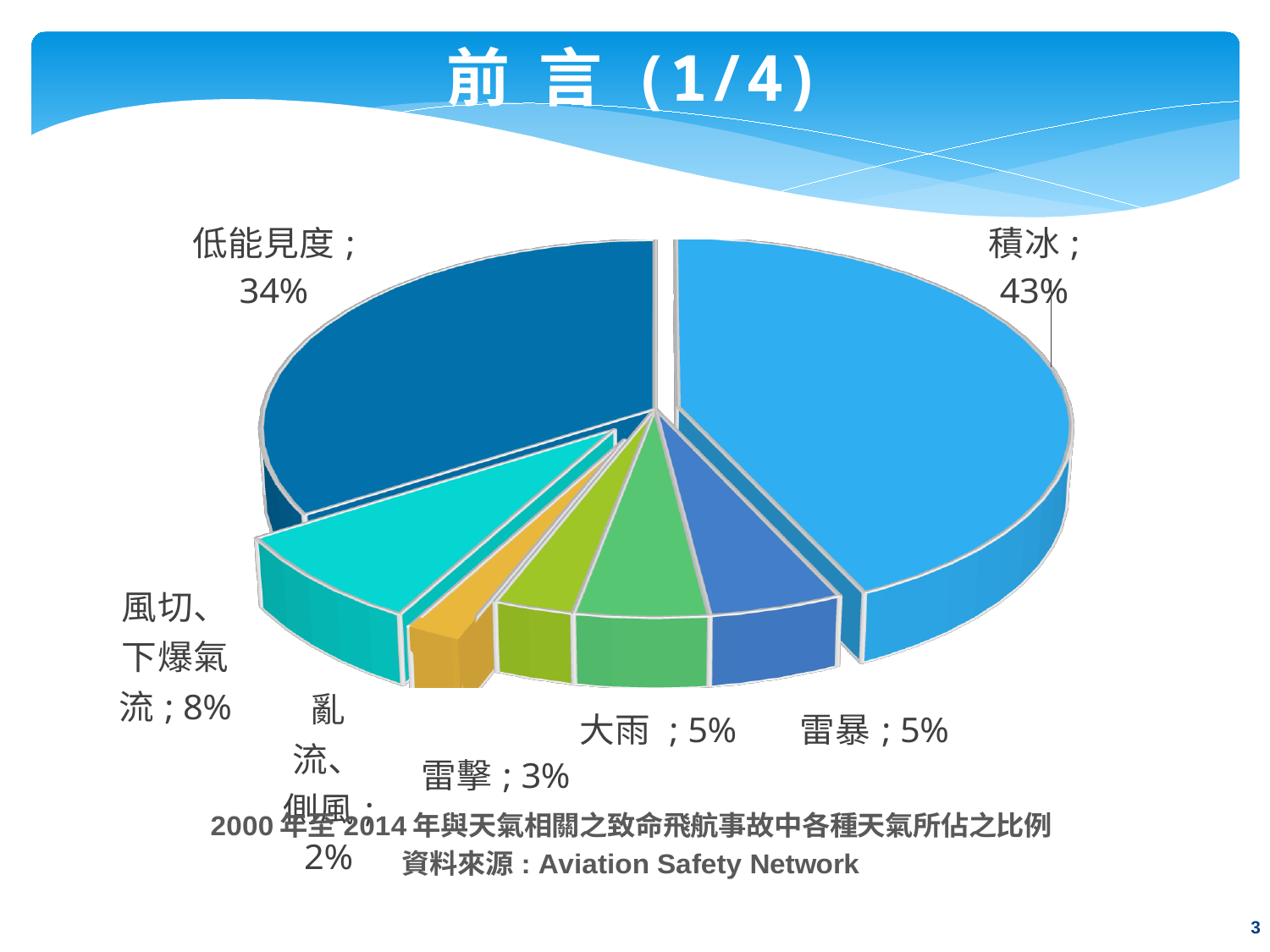
What is the value shown for 風切、下爆氣流? 8% What share of the pie does 積冰 account for? 43% Which category has the smallest slice of the pie? 亂流、側風 What is the value shown for 低能見度? 34% According to the caption, what is the data source for the chart? Aviation Safety Network What is the value shown for 雷擊? 3% What is the difference between the shares of 積冰 and 低能見度? 9% How many categories are shown in the pie chart? 7 What is the value shown for 亂流、側風? 2% What kind of chart is shown on the slide? pie chart Which category has the largest slice of the pie? 積冰 Which is larger, the share for 風切、下爆氣流 or the share for 大雨? 風切、下爆氣流